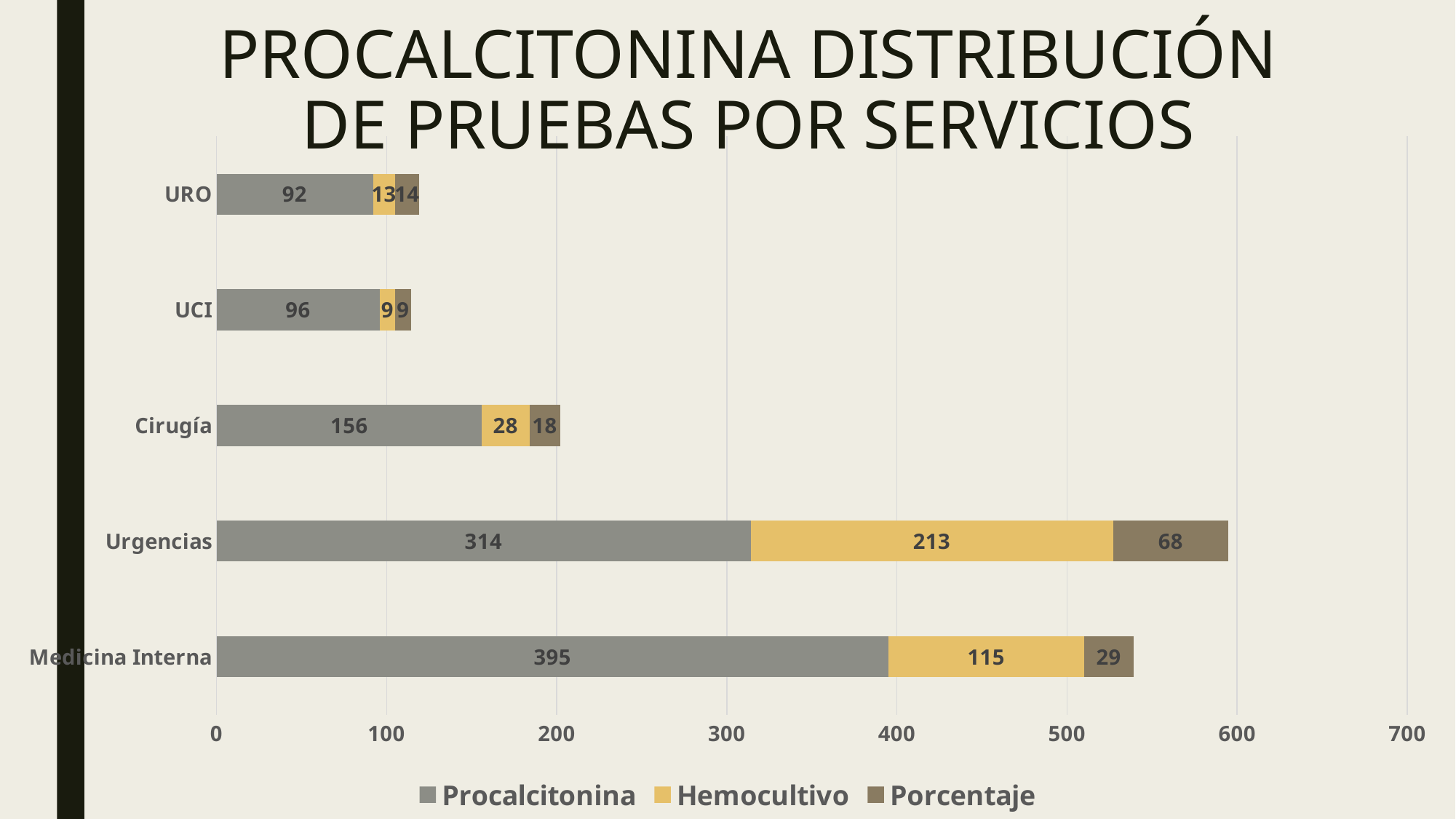
Which service has the lowest Hemocultivo value? UCI What is the title of the chart? PROCALCITONINA DISTRIBUCIÓN DE PRUEBAS POR SERVICIOS What type of chart is shown on the slide? Stacked bar chart Which is larger, the Hemocultivo value for Cirugía or the Hemocultivo value for URO? Cirugía How many services (categories) are shown on the chart? 5 How many series does the legend list? 3 What is the difference between the Procalcitonina values for Medicina Interna and Urgencias? 81 Which service has the highest Procalcitonina value? Medicina Interna What is the total of the stacked bar for Urgencias? 595 What is the Procalcitonina value for Medicina Interna? 395 What is the Hemocultivo value for Urgencias? 213 What is the Porcentaje value for Cirugía? 18